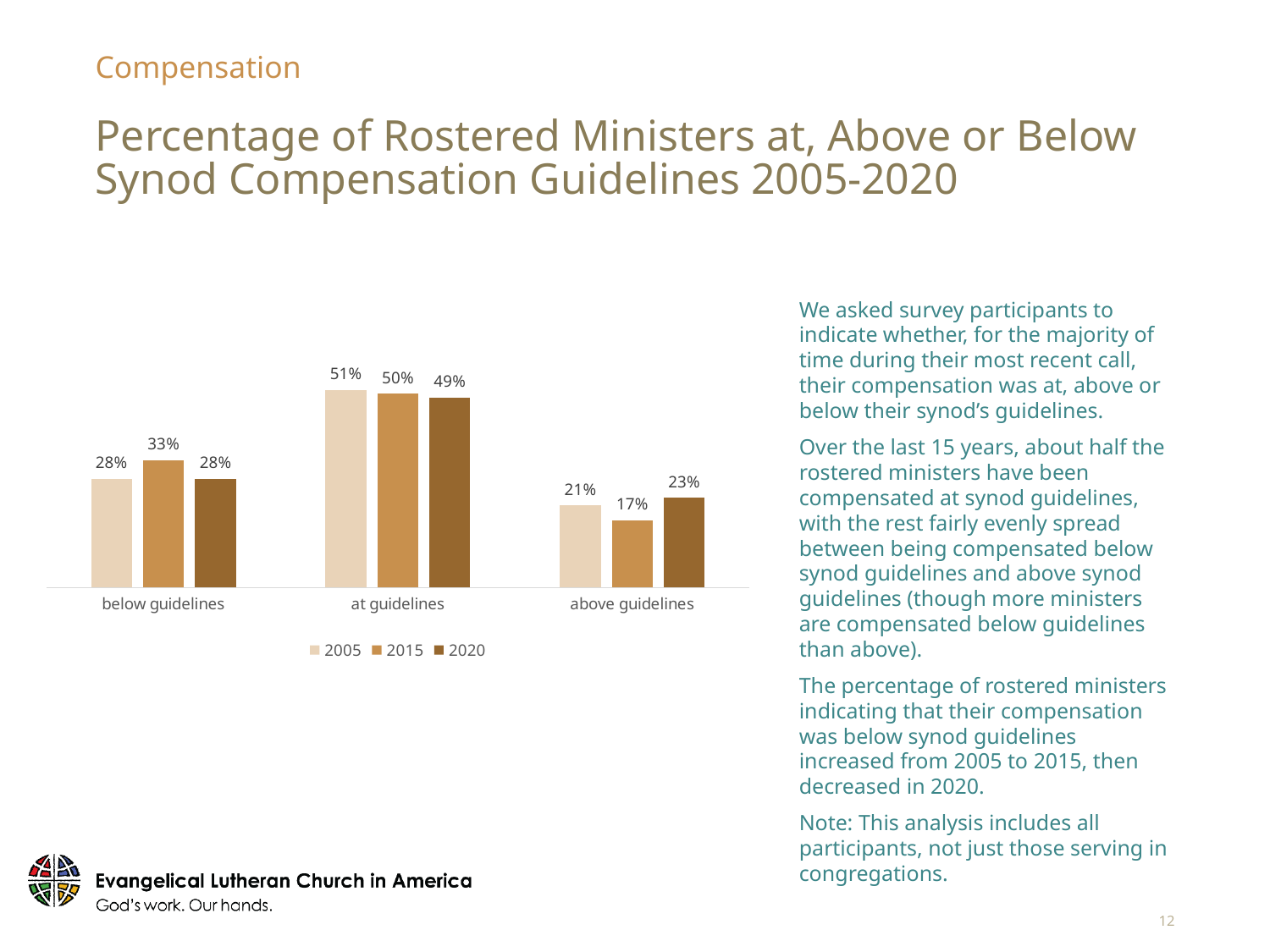
What percentage of rostered ministers were compensated above guidelines in 2005? 21% What percentage of rostered ministers were compensated below guidelines in 2015? 33% What years are listed in the chart legend? 2005, 2015, 2020 Which category has the lowest value for the 2015 series? above guidelines Which is larger: the 2005 value for below guidelines or the 2005 value for above guidelines? below guidelines Does the value for at guidelines rise or fall from 2005 to 2020? fall Which category has the highest value for the 2005 series? at guidelines What kind of chart is shown on the slide? bar chart How many series does the legend list? 3 What is the difference between the 2015 and 2020 values for above guidelines? 6% How many categories are shown on the x axis? 3 What percentage of rostered ministers were compensated at guidelines in 2020? 49%